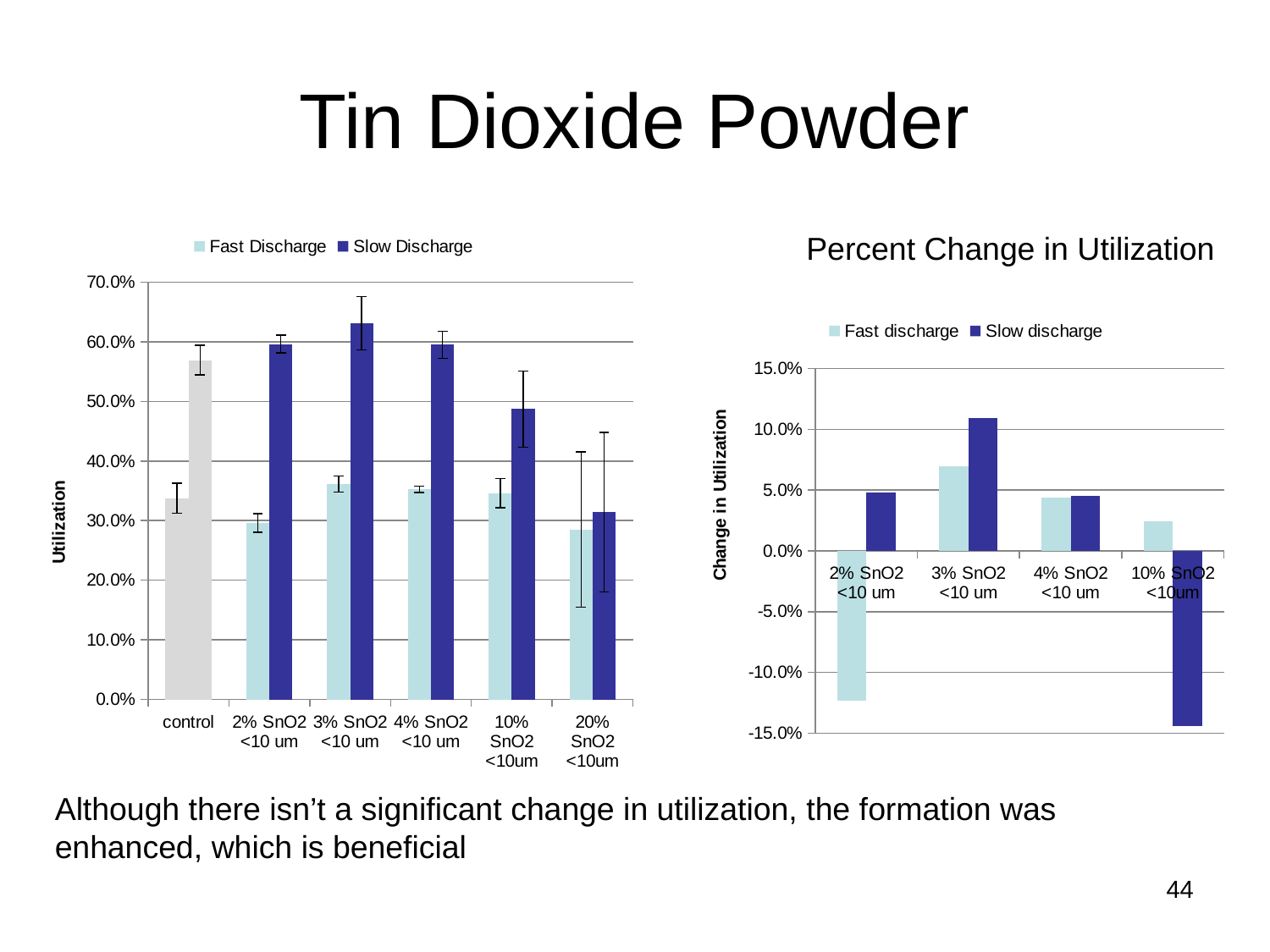
On the Percent Change in Utilization chart, how many series does the legend list? 2 On the Percent Change in Utilization chart, which category has the lowest Fast discharge change? 2% SnO2 <10 um On the left chart, how many categories are shown on the x axis? 6 On the left chart, is the Fast Discharge utilization for 3% SnO2 <10 um greater or less than 30.0%? greater On the left chart, is the Slow Discharge utilization for 3% SnO2 <10 um greater or less than 60.0%? greater On the left chart, is the Slow Discharge utilization for control greater or less than 60.0%? less On the left chart, which category has the lowest Slow Discharge utilization? 20% SnO2 <10um On the left chart, which category has the highest Slow Discharge utilization? 3% SnO2 <10 um What kind of chart is the Percent Change in Utilization chart? bar chart On the Percent Change in Utilization chart, which category has the highest Slow discharge change? 3% SnO2 <10 um On the left chart, which is larger for control: Fast Discharge or Slow Discharge? Slow Discharge